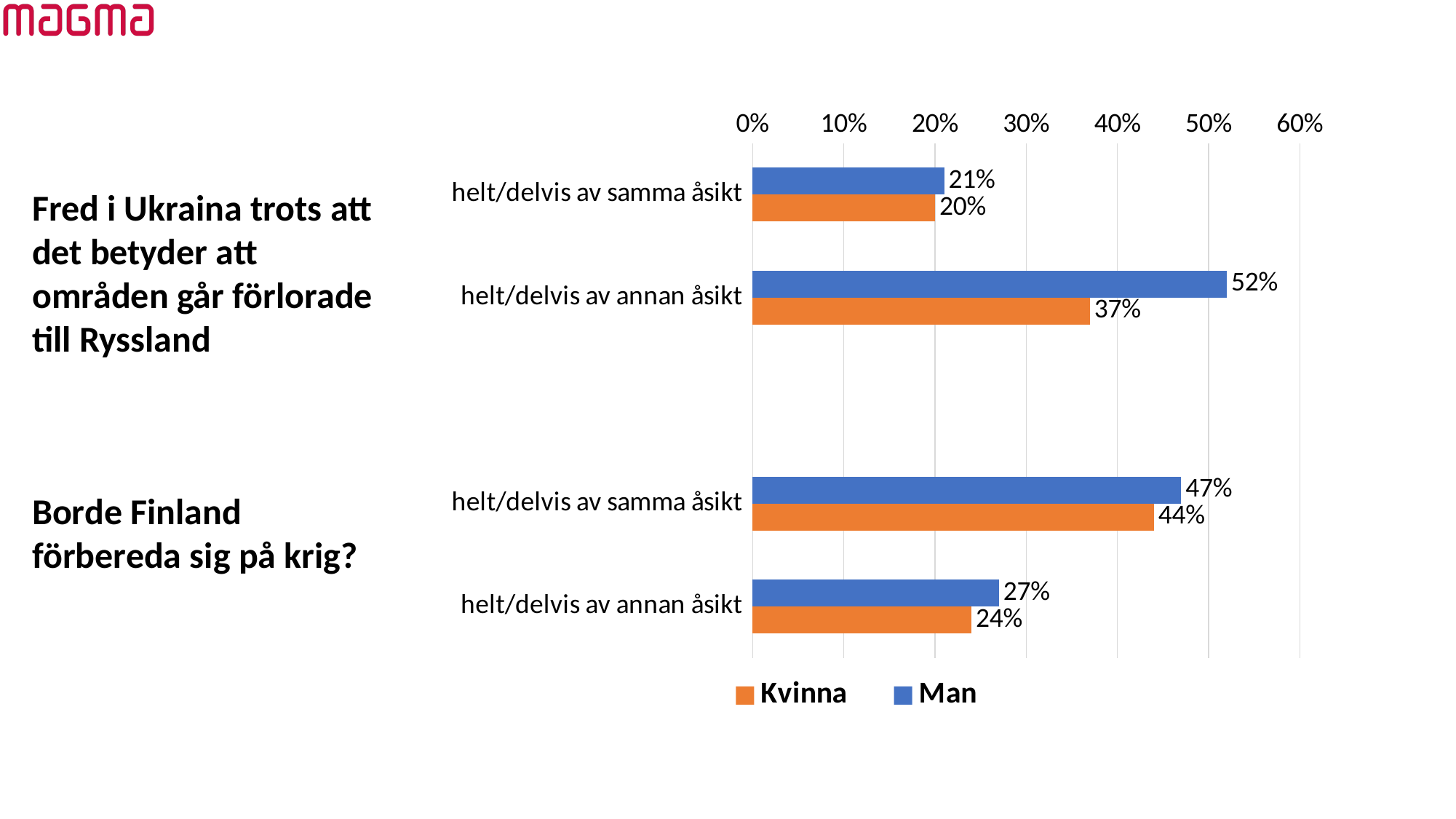
For the question 'Fred i Ukraina trots att det betyder att områden går förlorade till Ryssland', what is the difference between Man and Kvinna in 'helt/delvis av annan åsikt'? 15% Which bar has the highest value on the whole chart? Man, helt/delvis av annan åsikt (Fred i Ukraina) For the question 'Fred i Ukraina trots att det betyder att områden går förlorade till Ryssland', what is the value for Man in 'helt/delvis av annan åsikt'? 52% How many category rows are plotted on the chart in total? 4 How many series does the legend list? 2 Which series is shown in orange in the legend? Kvinna For the question 'Borde Finland förbereda sig på krig?', which is larger in 'helt/delvis av annan åsikt', Kvinna or Man? Man What kind of chart is shown on the slide? bar chart For the question 'Borde Finland förbereda sig på krig?', what is the value for Kvinna in 'helt/delvis av samma åsikt'? 44% For the question 'Borde Finland förbereda sig på krig?', what is the value for Man in 'helt/delvis av annan åsikt'? 27% For the question 'Borde Finland förbereda sig på krig?', what is the difference between Man and Kvinna in 'helt/delvis av samma åsikt'? 3% For the question 'Fred i Ukraina trots att det betyder att områden går förlorade till Ryssland', what is the value for Kvinna in 'helt/delvis av samma åsikt'? 20%